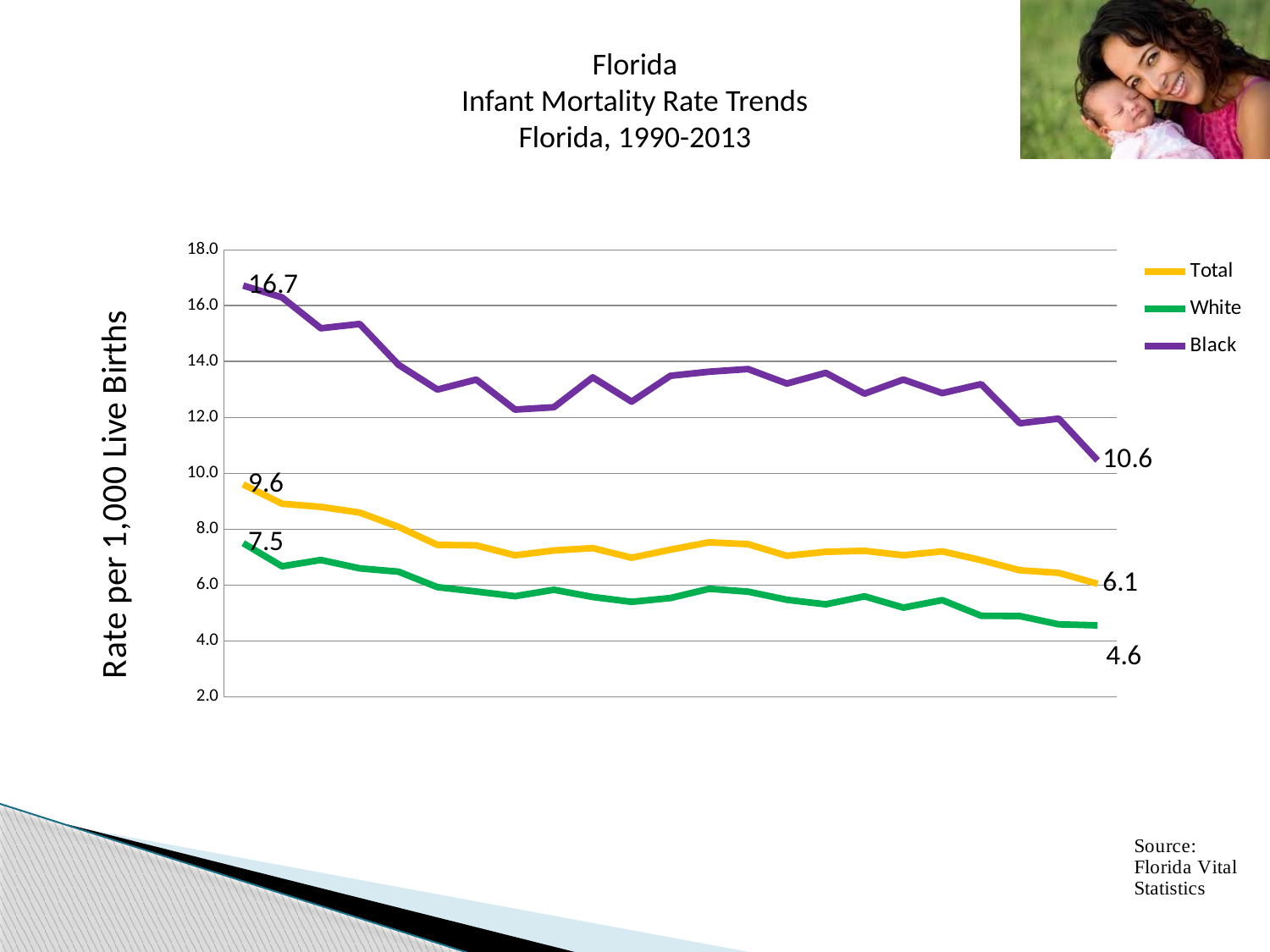
What is the difference between the last labelled values of the Total series and the White series? 1.5 What is the last labelled value of the White series? 4.6 What kind of chart is shown on the slide? line chart Is the final value of the White series greater or less than 6.0? less What is the first labelled value of the Total series? 9.6 By how much did the Black series fall from its first labelled value to its last labelled value? 6.1 Which series has the lowest values throughout the chart? White What is the last labelled value of the Black series? 10.6 Which series has the highest values throughout the chart? Black Is the last labelled value of the Total series larger or smaller than the last labelled value of the Black series? smaller What is the first labelled value of the Black series? 16.7 How many series does the legend list? 3